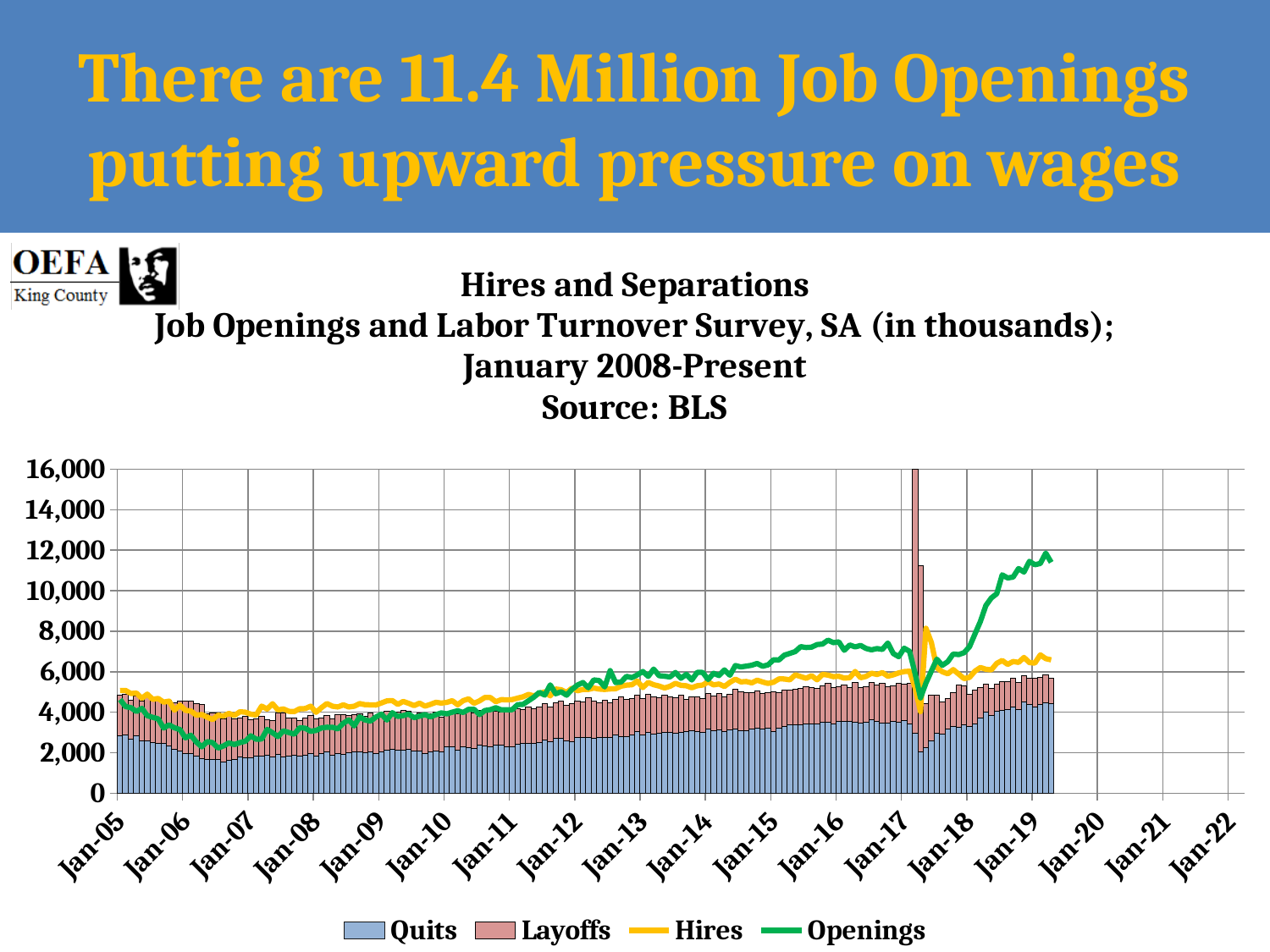
How many series does the legend list? 4 Is the value of the Openings line around Jan-06 greater or less than 4,000? less Is the Quits value at Jan-05 greater or less than 4,000? less Is the value of the Hires line at Jan-05 greater or less than 4,000? greater How many year labels are shown on the x axis? 18 Around Jan-06, which is higher, the Hires line or the Openings line? Hires What kind of chart is shown on the slide? A combination of a stacked bar chart and a line chart Does the Openings line rise or fall between Jan-17 and Jan-19? Rises At the final plotted point, which is higher, the Openings line or the Hires line? Openings What colour is the Openings line? Green Which series are plotted as bars rather than lines? Quits and Layoffs